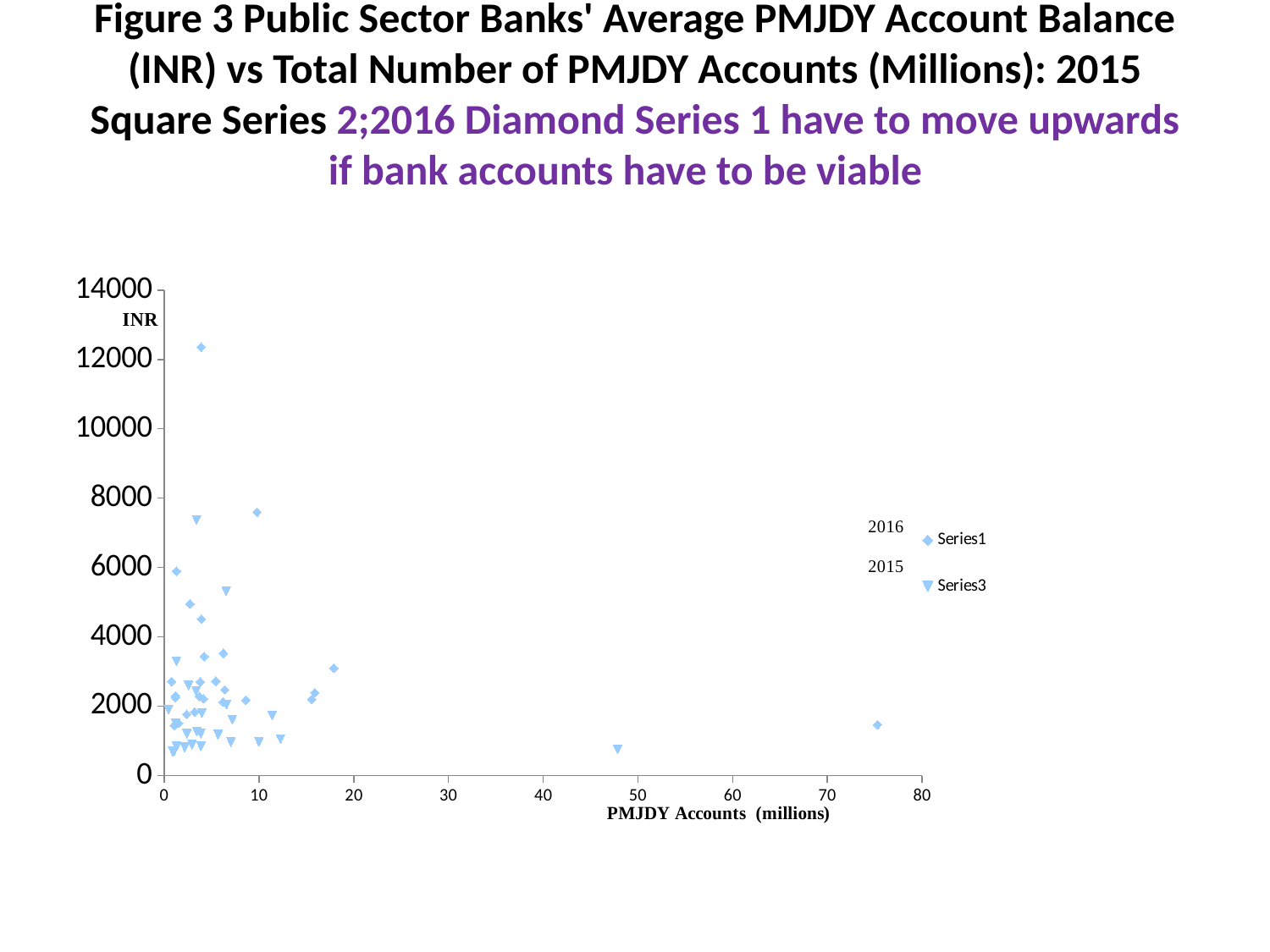
What is the label on the x axis of the chart? PMJDY Accounts (millions) What is the highest value shown on the x axis? 80 Which series has the point with the highest average account balance, Series1 or Series3? Series1 Is the highest Series3 (triangle) point greater or less than 8000 INR? less What kind of chart is shown on the slide? Scatter chart Which series has the point with the largest number of PMJDY accounts, Series1 or Series3? Series1 How many series does the chart's legend list? 2 Is the Series3 (triangle) point near 48 million accounts greater or less than 2000 INR? less What are the names of the two series in the legend? Series1 and Series3 Is the highest Series1 (diamond) point greater or less than 12000 INR? greater What is the highest value shown on the y axis? 14000